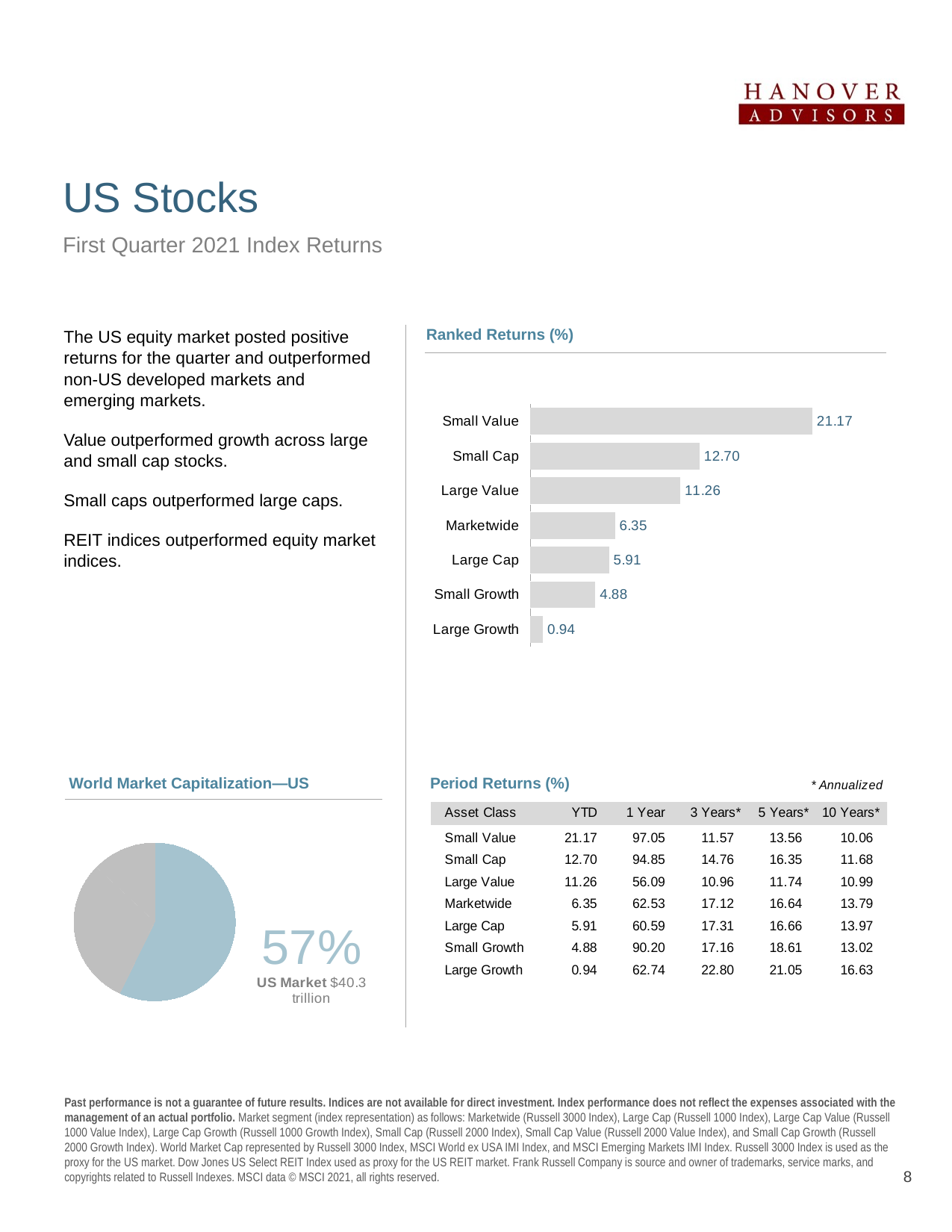
What kind of chart is the Ranked Returns (%) chart? Bar chart In the Ranked Returns (%) chart, what is the value for Large Growth? 0.94 What kind of chart is the World Market Capitalization—US chart? Pie chart In the Ranked Returns (%) chart, which category has the highest value? Small Value In the Ranked Returns (%) chart, what is the value for Small Value? 21.17 In the Ranked Returns (%) chart, what is the difference between Small Cap and Large Value? 1.44 How many categories are shown in the Ranked Returns (%) chart? 7 In the Ranked Returns (%) chart, which category has the lowest value? Large Growth In the World Market Capitalization—US chart, what is the size of the US market shown below the percentage? $40.3 trillion In the Ranked Returns (%) chart, what is the value for Marketwide? 6.35 In the World Market Capitalization—US chart, what share of world market capitalization does the US market represent? 57% In the Ranked Returns (%) chart, which is larger, Large Cap or Small Growth? Large Cap